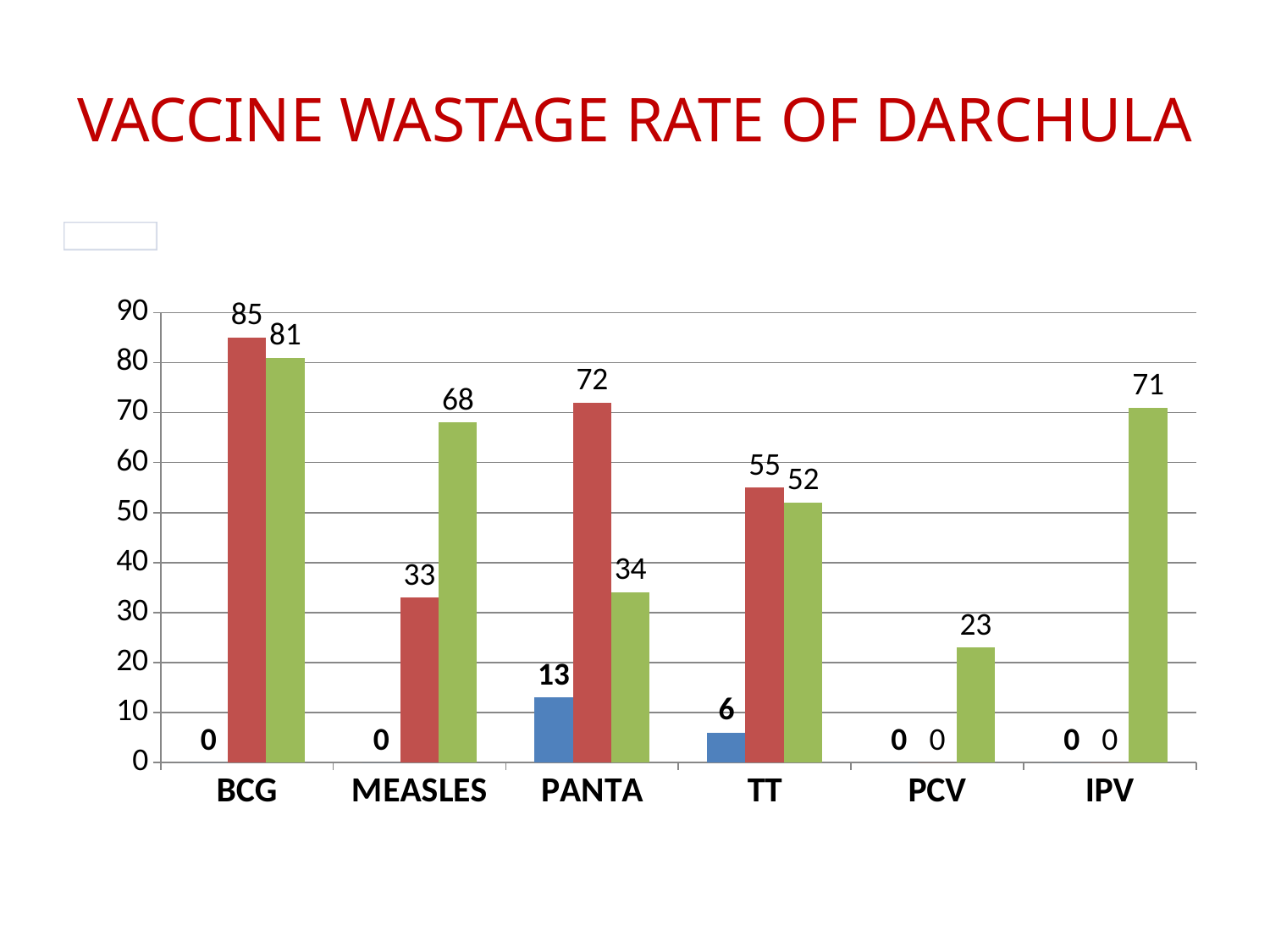
How many categories are shown on the x axis? 6 What is the difference between the red and green bars for PANTA? 38 Which category has the lowest green bar? PCV What is the value of the red bar for BCG? 85 What is the value of the blue bar for PANTA? 13 What kind of chart is shown on the slide? bar chart What is the value of the green bar for IPV? 71 Which category has the highest red bar? BCG What is the value of the green bar for MEASLES? 68 What is the value of the green bar for PCV? 23 What is the title of the slide? VACCINE WASTAGE RATE OF DARCHULA Which is larger for MEASLES, the red bar or the green bar? the green bar